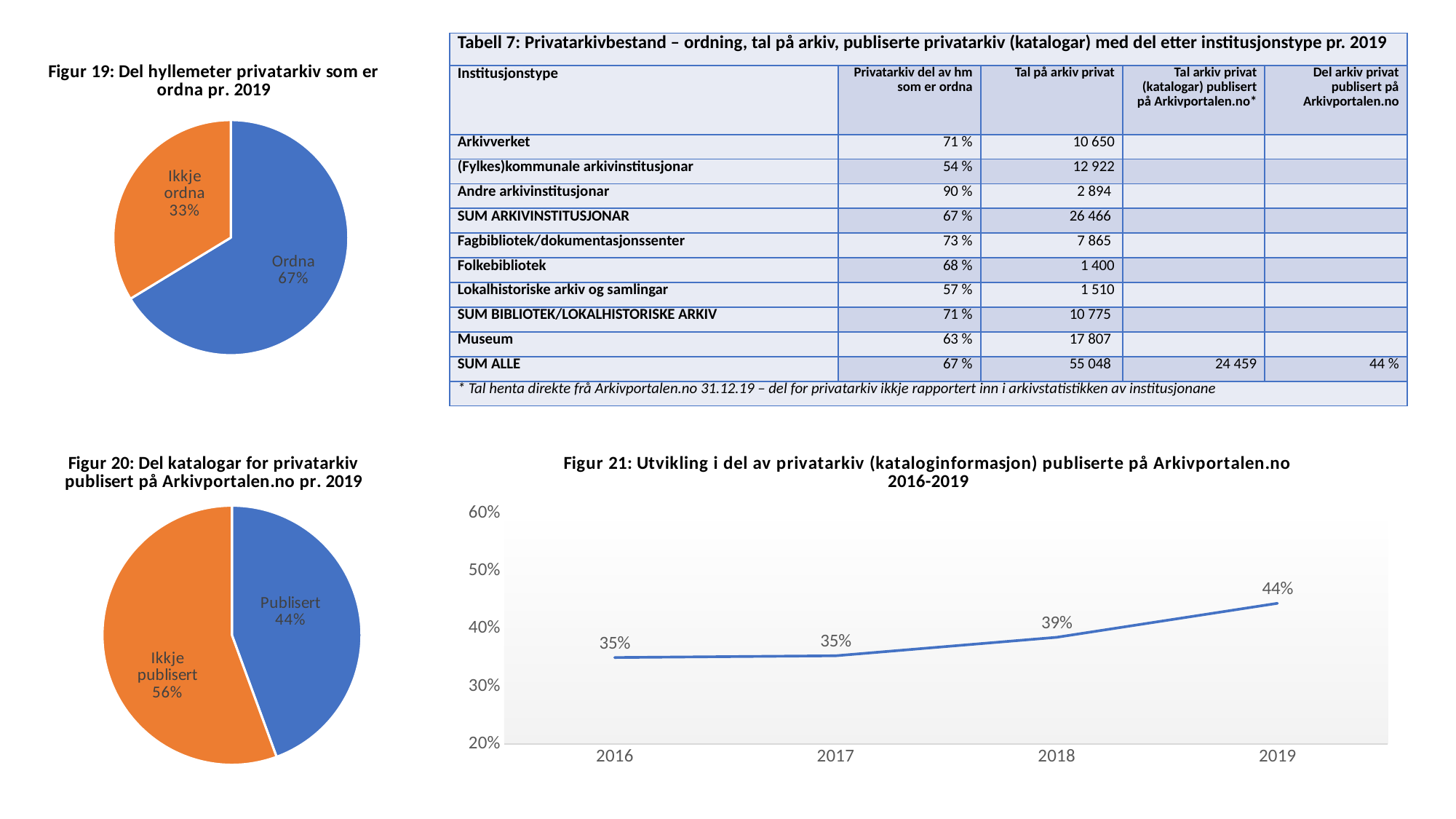
In Figur 20, what share of the pie is labelled Ikkje publisert? 56% In Figur 19, what share of the pie is labelled Ordna? 67% In Figur 19, what share of the pie is labelled Ikkje ordna? 33% In Figur 20, which slice is larger, Publisert or Ikkje publisert? Ikkje publisert In Figur 21, do the values rise or fall from 2016 to 2019? Rise In Figur 21, what is the value for 2016? 35% In Figur 21, what is the difference between the 2019 value and the 2017 value? 9 percentage points In Figur 21, what is the value for 2018? 39% In Figur 20, how many slices does the pie have? 2 What kind of chart is Figur 19? Pie chart In Figur 21, which year has the highest value? 2019